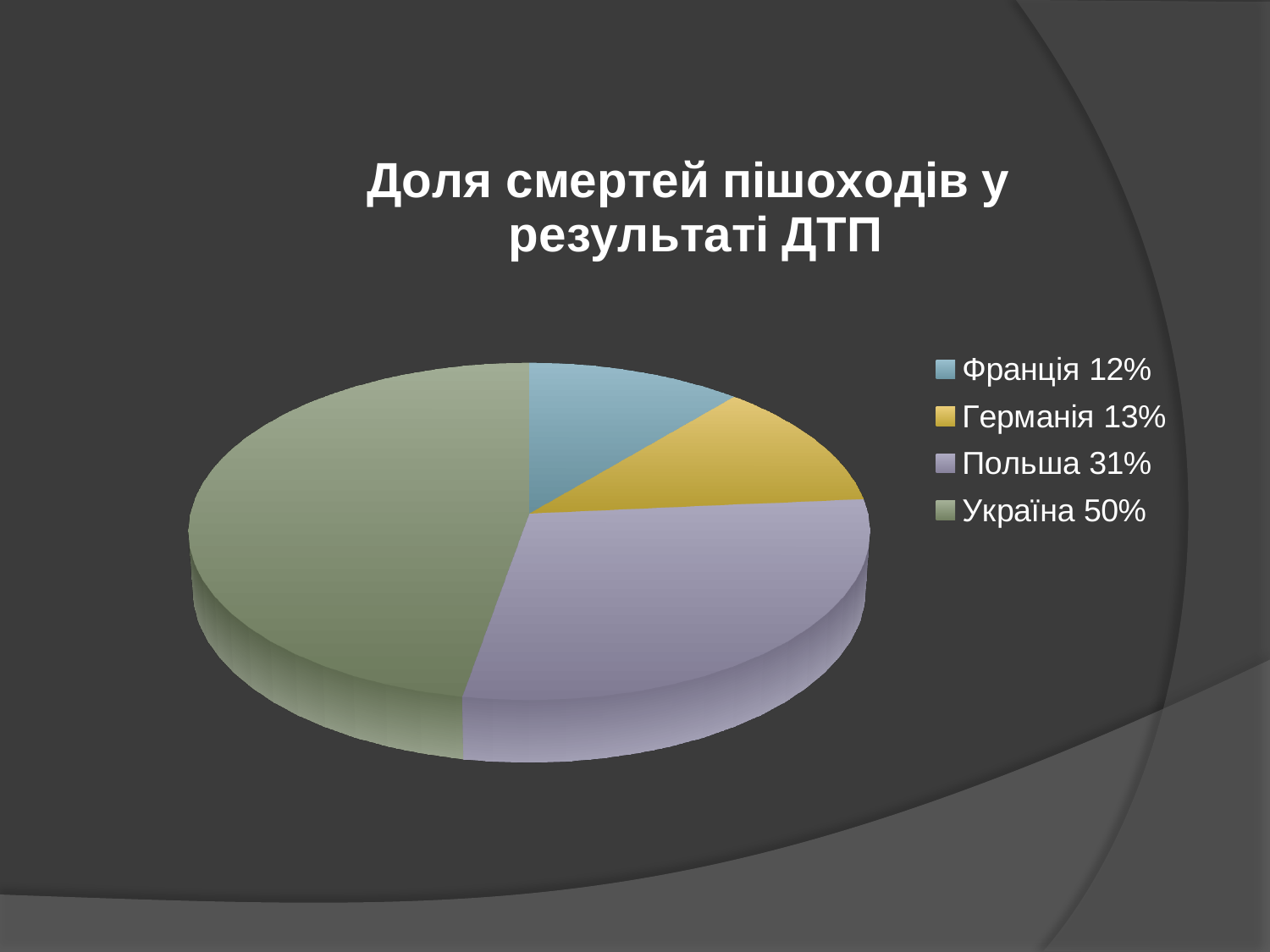
What is the difference between the shares of Україна and Польша? 19% What share of the pie does Україна have? 50% How many slices does the pie chart have? 4 What is the value shown for Германія? 13% Which country has the smallest slice of the pie? Франція Which is larger, the share for Польша or the share for Германія? Польша Which colour represents Україна in the pie chart? green Which country has the largest slice of the pie? Україна What kind of chart is shown on the slide? pie chart What is the value shown for Франція? 12% What is the title of the chart? Доля смертей пішоходів у результаті ДТП What share of the pie does Польша have? 31%